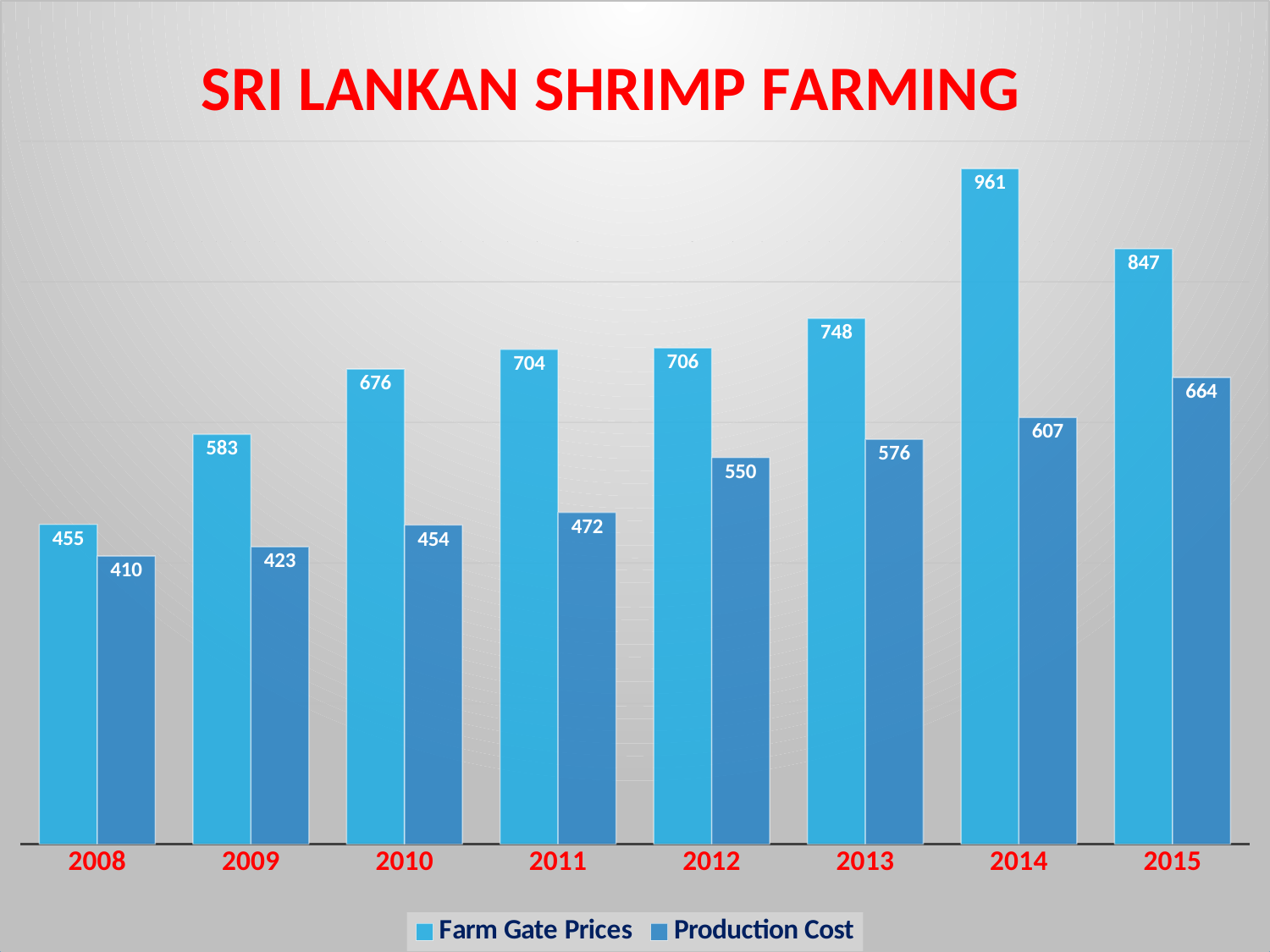
What is the Production Cost value for 2011? 472 Does the Production Cost rise or fall from 2008 to 2015? Rise Which is larger in 2012: Farm Gate Prices or Production Cost? Farm Gate Prices How many series does the legend list? 2 How many years are shown on the x axis? 8 Which year has the highest Farm Gate Prices value? 2014 Which year has the lowest Production Cost value? 2008 What is the title of the chart? SRI LANKAN SHRIMP FARMING What kind of chart is shown on the slide? Bar chart What is the difference in Farm Gate Prices between 2014 and 2013? 213 What is the Farm Gate Prices value for 2014? 961 What is the difference between Farm Gate Prices and Production Cost in 2015? 183